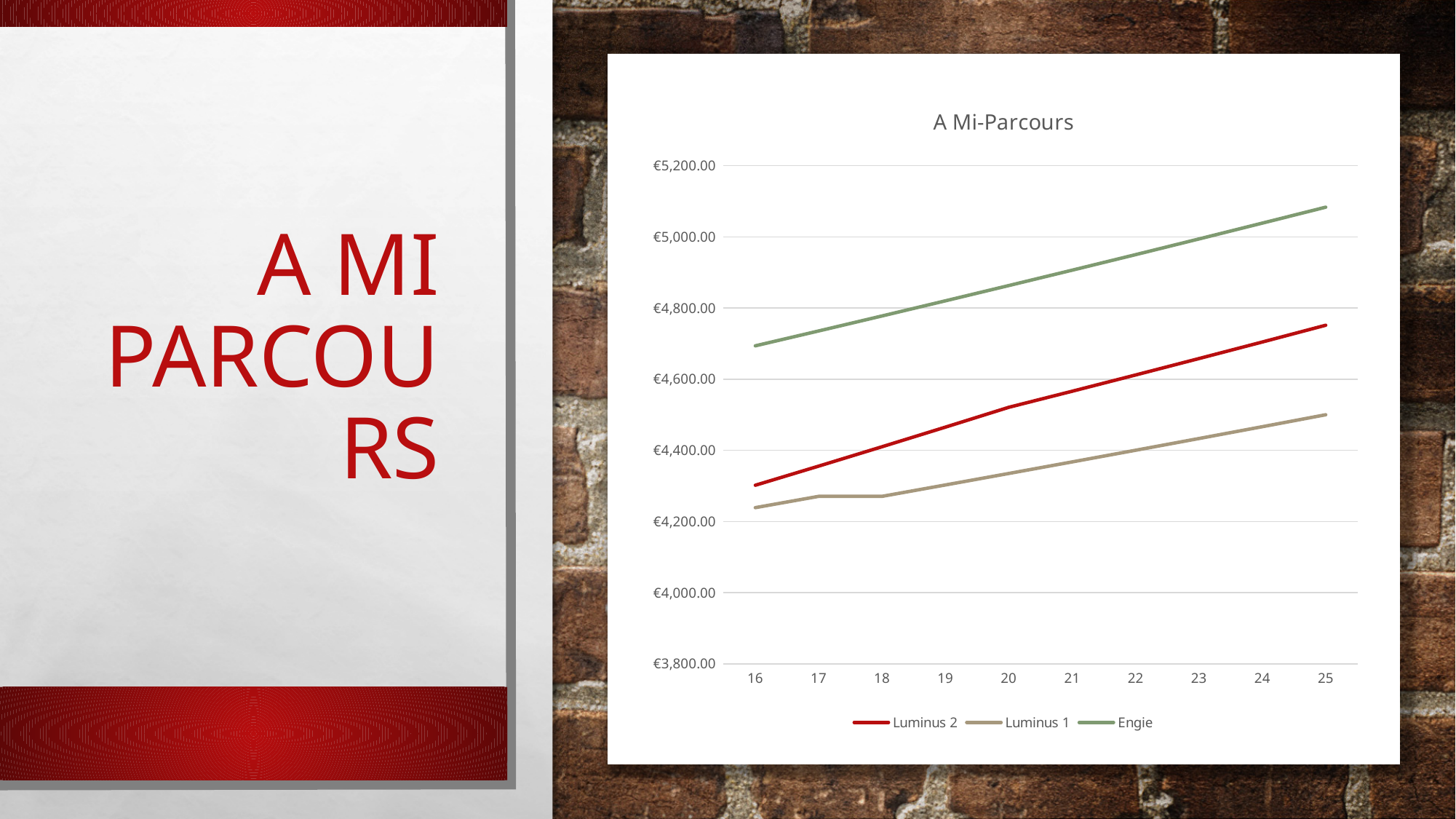
Which series is drawn in green in the chart? Engie Is the value for Engie at 16 greater or less than €4,800.00? less How many series does the legend of the chart list? 3 Is the value for Engie at 25 greater or less than €5,000.00? greater Which series has the lowest value at 16? Luminus 1 At 20, which is larger: the value for Engie or the value for Luminus 1? Engie What kind of chart is shown on the slide? line chart Which series has the highest value at 25? Engie Is the value for Luminus 2 at 16 greater or less than €4,200.00? greater Does the Engie line rise or fall from 16 to 25? rise What is the title of the chart? A Mi-Parcours How many points are on the x axis of the chart? 10